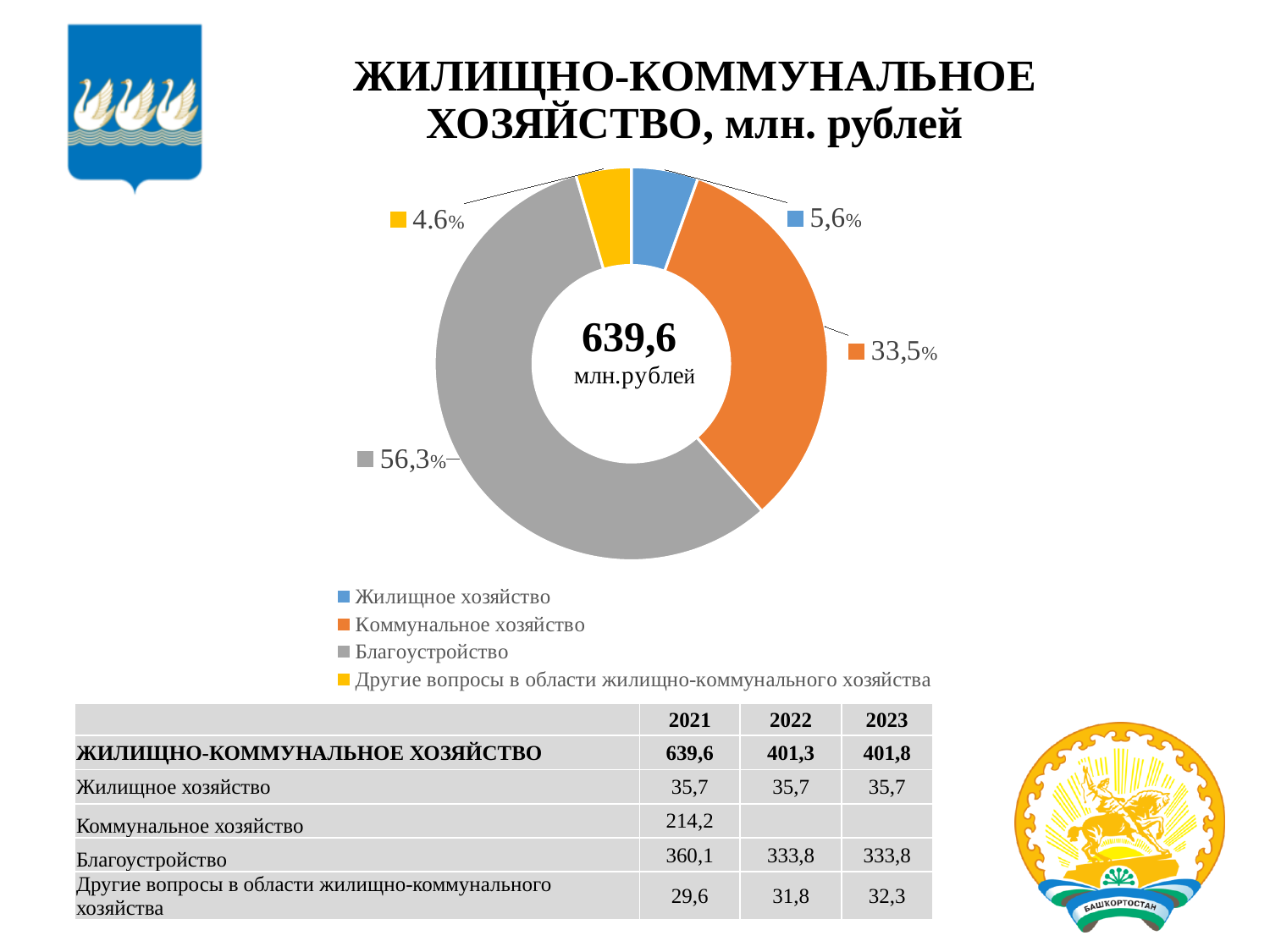
Which slice is larger: Жилищное хозяйство or Коммунальное хозяйство? Коммунальное хозяйство What percentage is shown for Коммунальное хозяйство in the doughnut chart? 33,5% Which category has the smallest slice in the doughnut chart? Другие вопросы в области жилищно-коммунального хозяйства Which category has the largest slice in the doughnut chart? Благоустройство What type of chart is shown on the slide? Doughnut (pie) chart What percentage is shown for Жилищное хозяйство in the doughnut chart? 5,6% How many categories are shown in the doughnut chart? 4 How many entries does the chart legend list? 4 What percentage is shown for Другие вопросы в области жилищно-коммунального хозяйства in the doughnut chart? 4.6% What share of the doughnut chart does Благоустройство account for? 56,3% By how many percentage points does the Благоустройство slice exceed the Коммунальное хозяйство slice? 22,8 What total value is printed in the centre of the doughnut chart? 639,6 млн.рублей